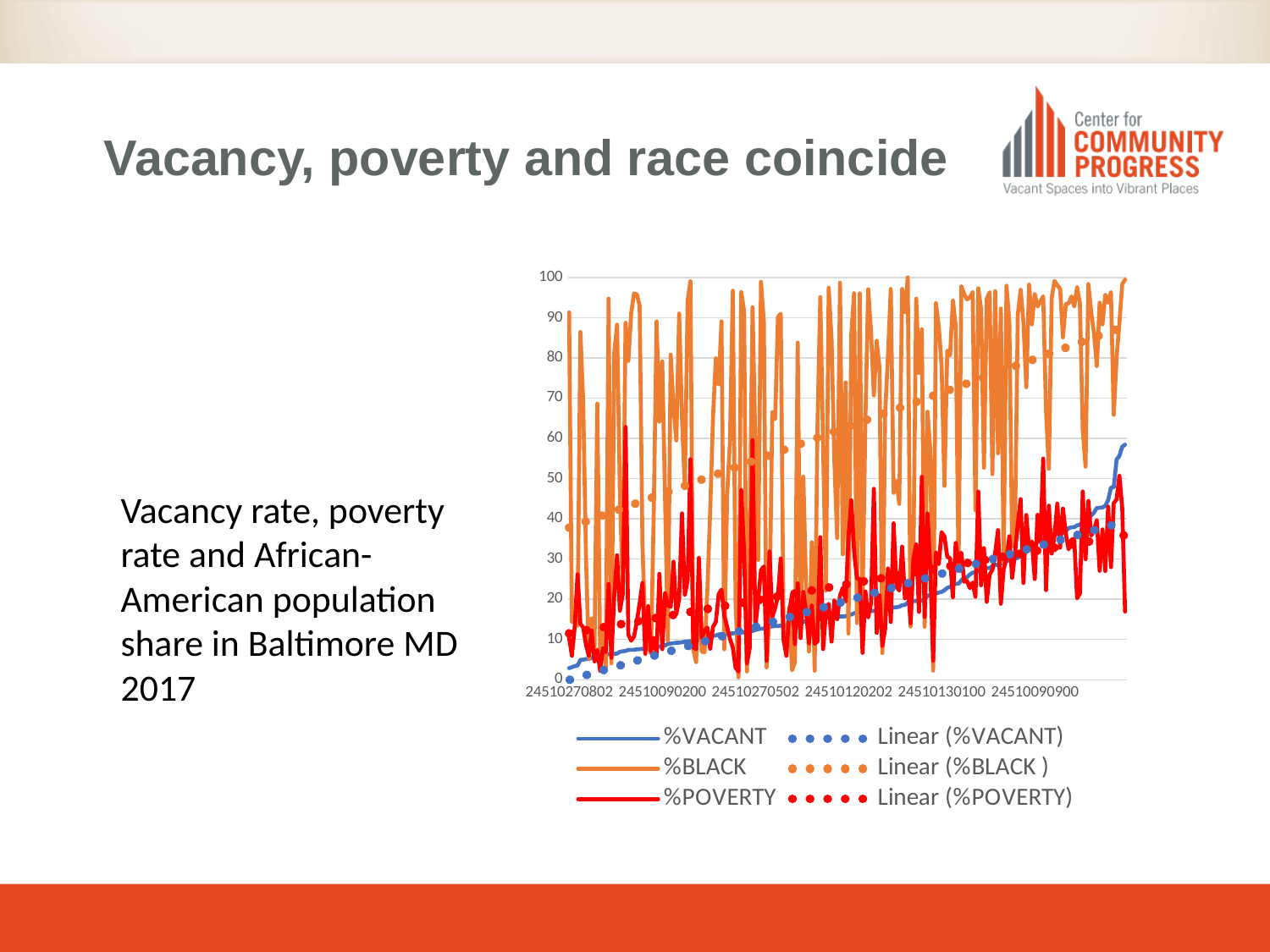
Does the %VACANT line rise or fall moving from left to right along the x axis? rise How many entries does the chart's legend list? 6 What kind of chart is shown on the slide? line chart Does the dotted Linear (%POVERTY) trendline rise or fall from left to right? rise How many tract ID labels are printed along the chart's x axis? 6 Is the %VACANT value at the far left end of the x axis greater or less than 10? less What is the highest value shown on the chart's y axis? 100 Is the %VACANT value at the far right end of the x axis greater or less than 50? greater Is the %BLACK value at the far right end of the x axis greater or less than 90? greater Which colour is used for the %POVERTY series in the chart? red